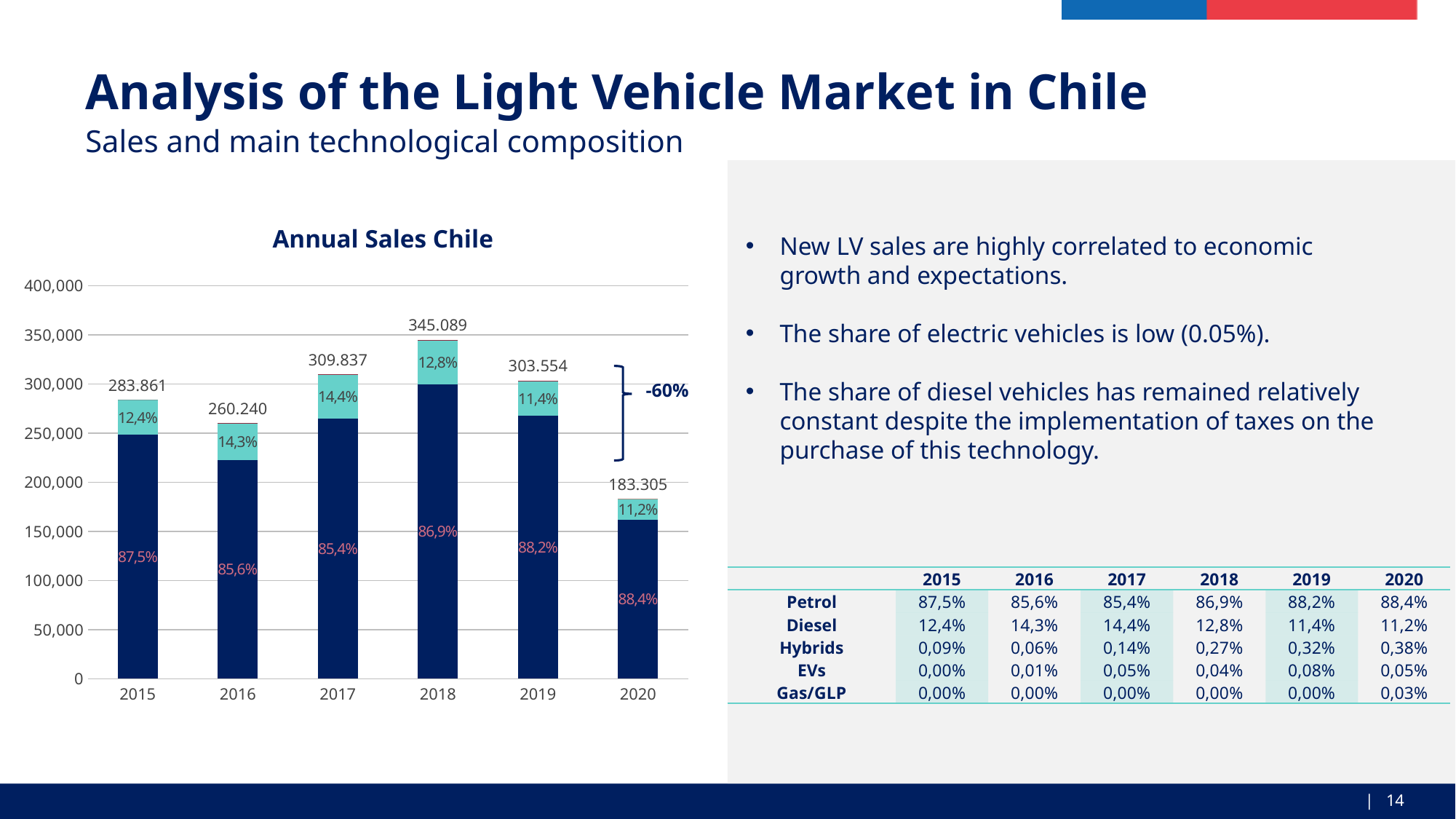
Which year has the lowest total annual sales in the Annual Sales Chile chart? 2020 What type of chart is shown under the title "Annual Sales Chile"? stacked bar chart What percentage change is annotated with the bracket between the 2019 and 2020 bars in the Annual Sales Chile chart? -60% In the Annual Sales Chile chart, which year has higher total sales, 2015 or 2019? 2019 What is the title of the chart on the slide? Annual Sales Chile In the Annual Sales Chile chart, what percentage is labelled on the dark blue (petrol) segment of the 2019 bar? 88,2% In the Annual Sales Chile chart, is the total for 2016 greater or less than 250,000? greater How many years are shown on the x axis of the Annual Sales Chile chart? 6 What is the total annual sales value labelled for 2020 in the Annual Sales Chile chart? 183.305 Which year has the highest total annual sales in the Annual Sales Chile chart? 2018 In the Annual Sales Chile chart, what percentage is labelled on the teal (diesel) segment of the 2017 bar? 14,4% What is the total annual sales value labelled for 2018 in the Annual Sales Chile chart? 345.089